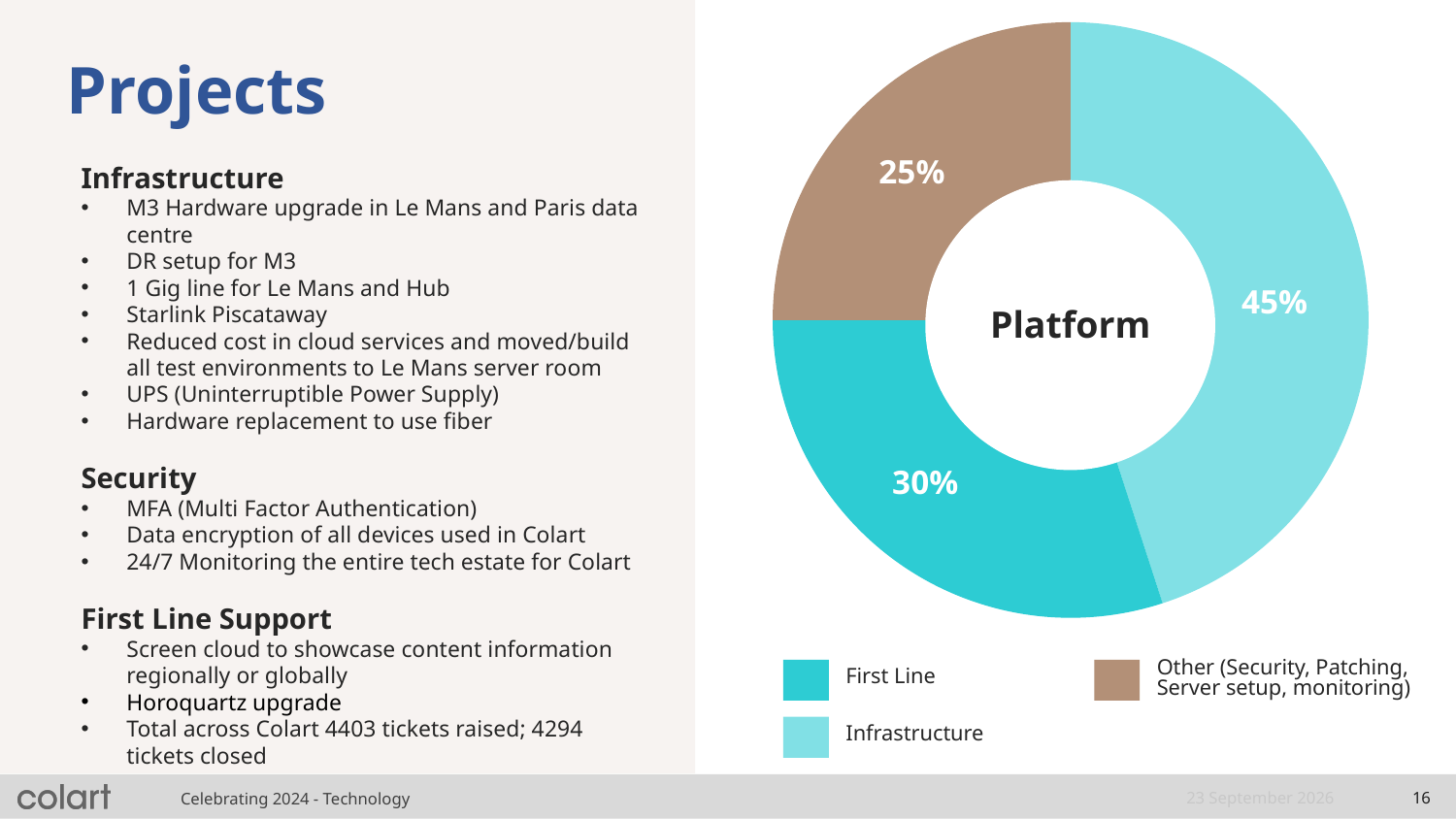
Which is larger in the pie chart, First Line or Other? First Line What word is written in the centre of the donut chart? Platform What percentage of the pie chart is First Line? 30% What is the difference in percentage points between the Infrastructure slice and the First Line slice? 15 Which slice of the pie chart is the smallest? Other (Security, Patching, Server setup, monitoring) What colour is the First Line slice in the pie chart? Teal What is the difference in percentage points between the First Line slice and the Other slice? 5 What kind of chart is shown on the slide? Pie chart (donut) What percentage of the pie chart is Other (Security, Patching, Server setup, monitoring)? 25% How many slices does the pie chart have? 3 What percentage of the pie chart is Infrastructure? 45% Which slice of the pie chart is the largest? Infrastructure